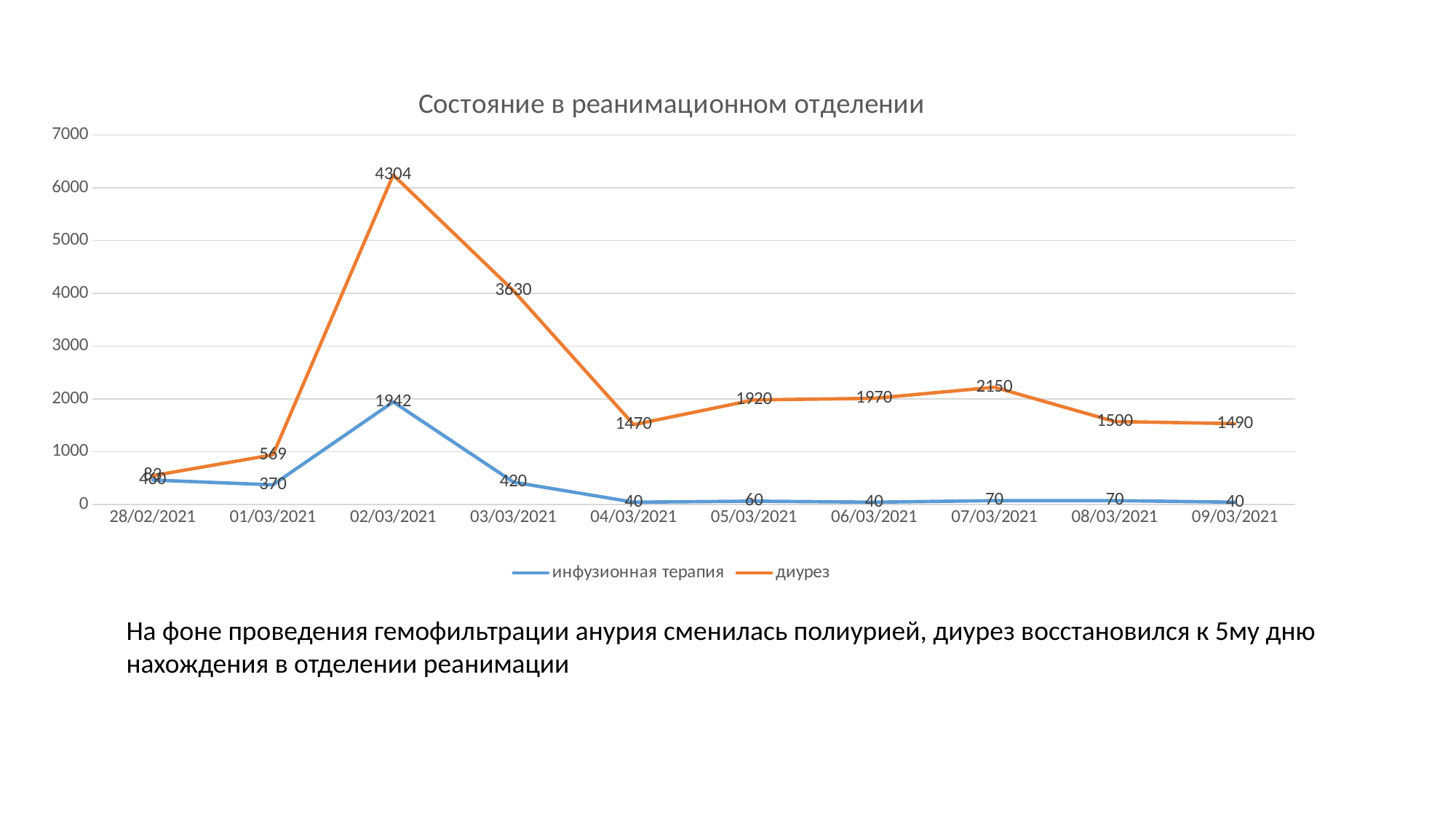
On which date is инфузионная терапия highest? 02/03/2021 How many series does the legend list? 2 What is the value of диурез on 01/03/2021? 569 Is the value of диурез on 02/03/2021 greater or less than 5000? less What is the value of диурез on 07/03/2021? 2150 What is the title of the chart? Состояние в реанимационном отделении What is the difference between диурез on 05/03/2021 and 04/03/2021? 450 On which date is диурез highest? 02/03/2021 Which is larger on 03/03/2021: диурез or инфузионная терапия? диурез What kind of chart is shown on the slide? line chart What is the value of инфузионная терапия on 02/03/2021? 1942 How many dates are plotted along the x axis? 10